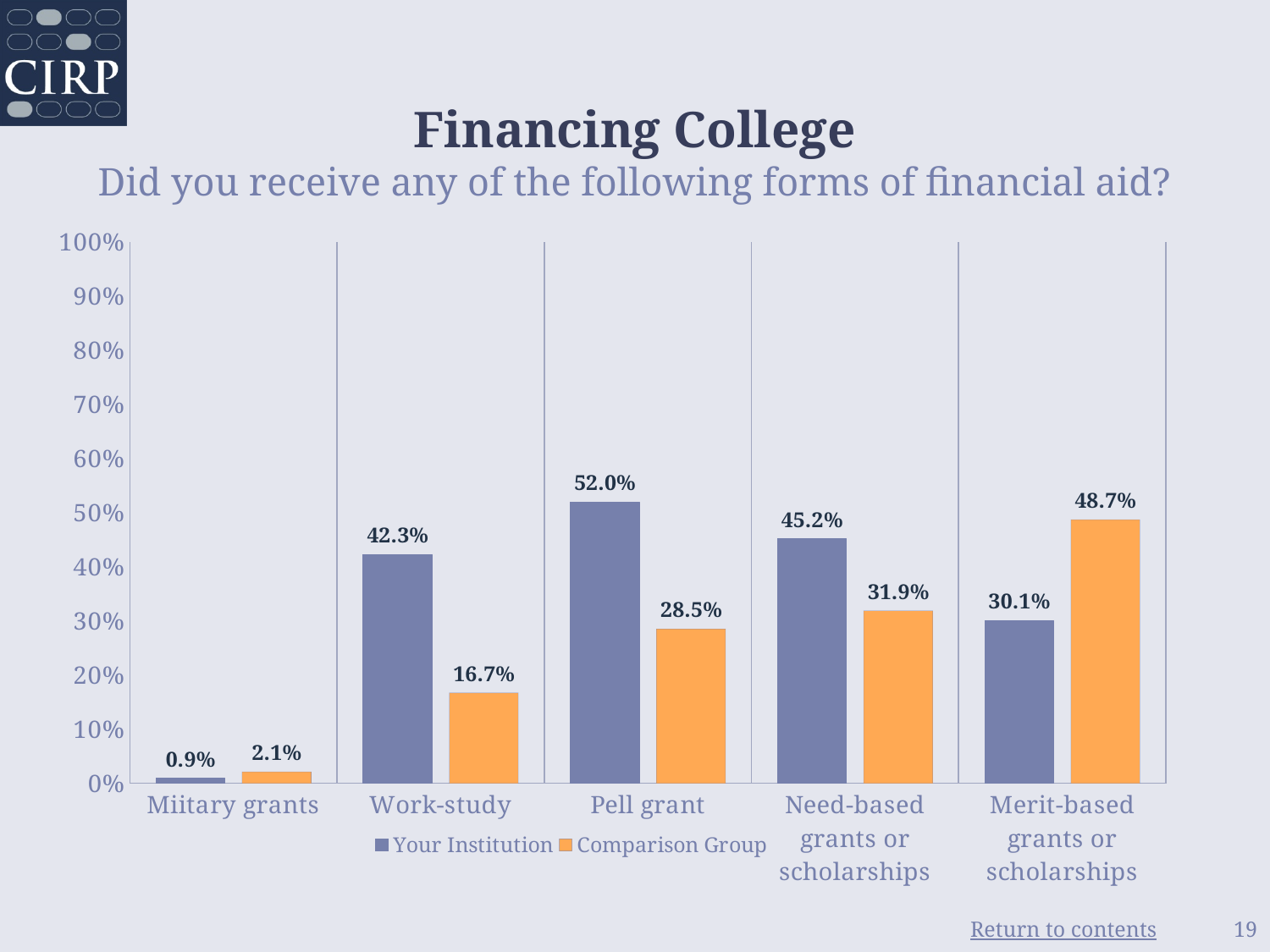
How many categories are shown on the x axis? 5 Is the value for Your Institution for Work-study greater or less than 40%? greater What is the value for Comparison Group for Work-study? 16.7% How many series does the legend list? 2 Which category has the highest value for Your Institution? Pell grant What is the difference between Your Institution and Comparison Group for Need-based grants or scholarships? 13.3% What kind of chart is shown on the slide? Bar chart Which category has the lowest value for Comparison Group? Miitary grants What is the value for Comparison Group for Merit-based grants or scholarships? 48.7% What is the value for Your Institution for Pell grant? 52.0% Which is larger for Merit-based grants or scholarships: Your Institution or Comparison Group? Comparison Group What colour are the Comparison Group bars? Orange